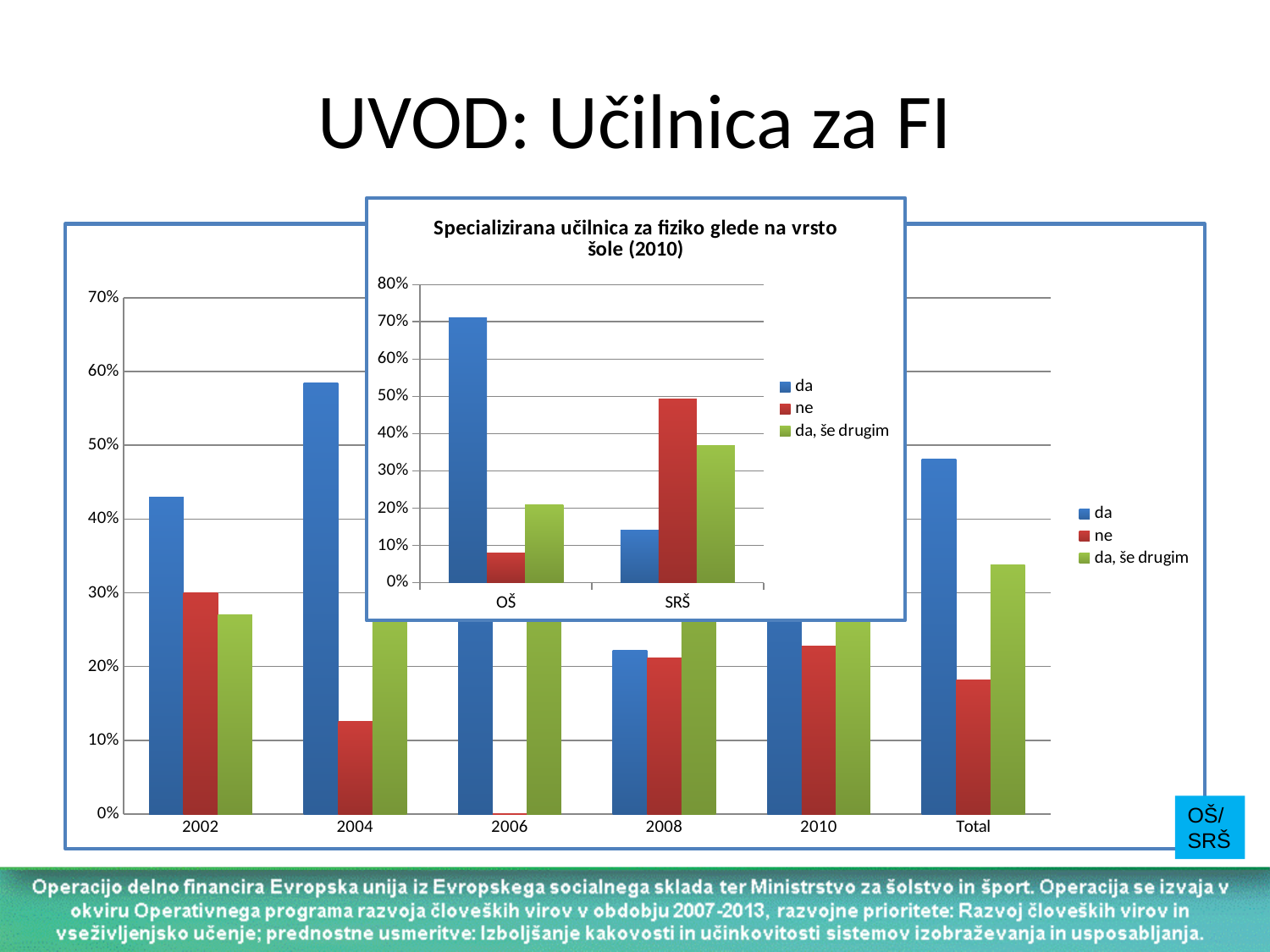
In the large background chart, how many categories are shown on the x axis? 6 In the large background chart, is the value of "ne" for 2004 greater or less than 20%? less In the inset chart "Specializirana učilnica za fiziko glede na vrsto šole (2010)", how many categories are shown on the x axis? 2 In the inset chart "Specializirana učilnica za fiziko glede na vrsto šole (2010)", how many series does the legend list? 3 What type of chart is the inset chart titled "Specializirana učilnica za fiziko glede na vrsto šole (2010)"? bar chart In the large background chart, which series has the lowest value for Total? ne In the inset chart "Specializirana učilnica za fiziko glede na vrsto šole (2010)", which series has the highest value for OŠ? da In the inset chart "Specializirana učilnica za fiziko glede na vrsto šole (2010)", is the value of "da" for OŠ greater or less than 60%? greater In the large background chart, is the value of "da" for 2004 greater or less than 50%? greater In the inset chart "Specializirana učilnica za fiziko glede na vrsto šole (2010)", which series has the highest value for SRŠ? ne In the inset chart "Specializirana učilnica za fiziko glede na vrsto šole (2010)", which category has the larger value for "da", OŠ or SRŠ? OŠ